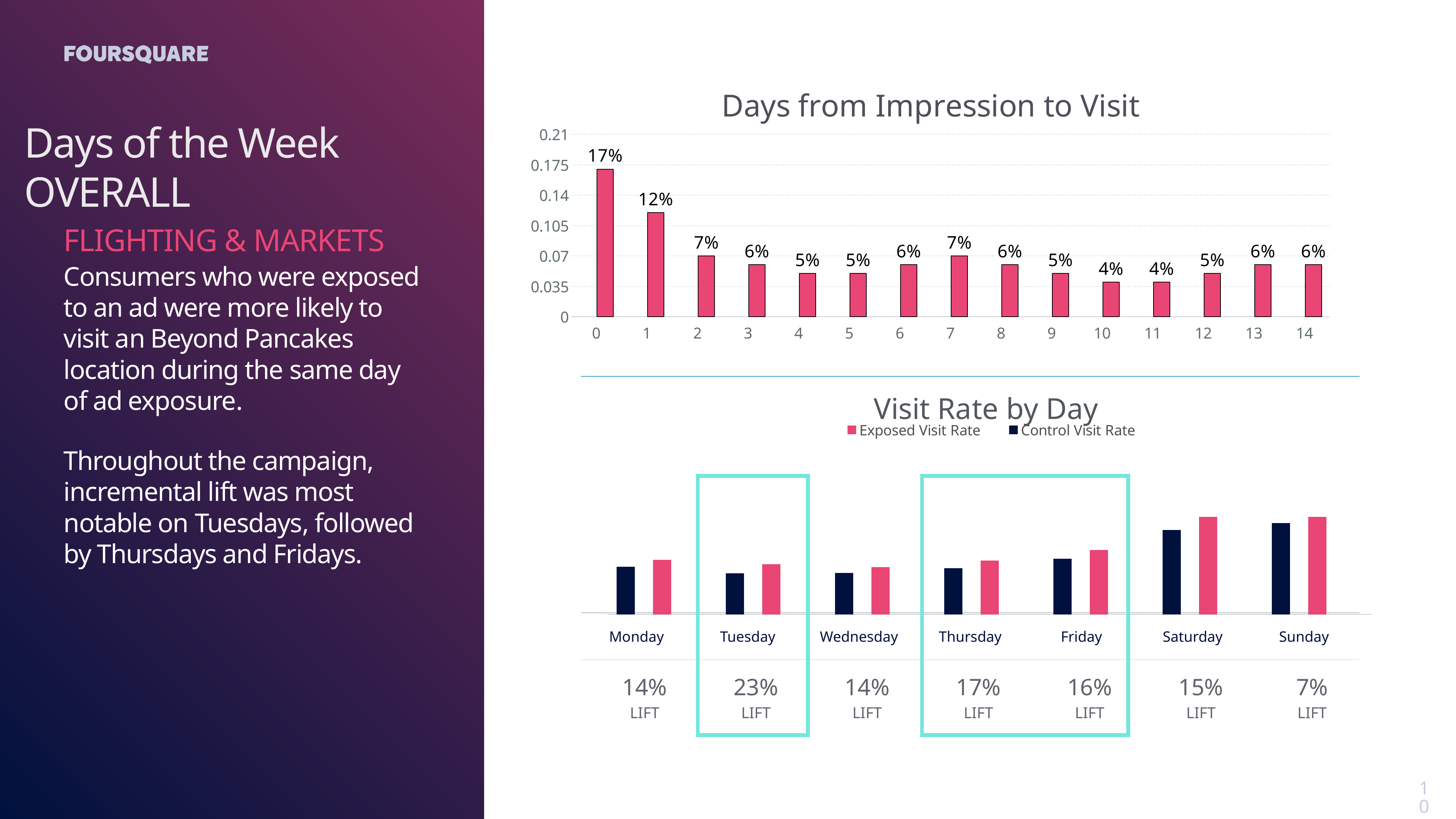
In the 'Days from Impression to Visit' chart, what is the difference between the values for day 0 and day 1? 5% What kind of chart is 'Visit Rate by Day'? bar chart In the 'Days from Impression to Visit' chart, what is the value for day 0? 17% In the 'Visit Rate by Day' chart, which series is shown in pink? Exposed Visit Rate In the 'Days from Impression to Visit' chart, what is the value for day 1? 12% In the 'Days from Impression to Visit' chart, do the values generally rise or fall from day 0 to day 4? fall In the 'Days from Impression to Visit' chart, which is larger, the value for day 2 or the value for day 4? day 2 How many series does the legend of the 'Visit Rate by Day' chart list? 2 In the 'Days from Impression to Visit' chart, which day has the highest value? 0 In the 'Days from Impression to Visit' chart, what is the value for day 7? 7% In the 'Visit Rate by Day' chart, which is larger on Friday, the Exposed Visit Rate or the Control Visit Rate? Exposed Visit Rate In the 'Days from Impression to Visit' chart, how many days are shown on the x axis? 15